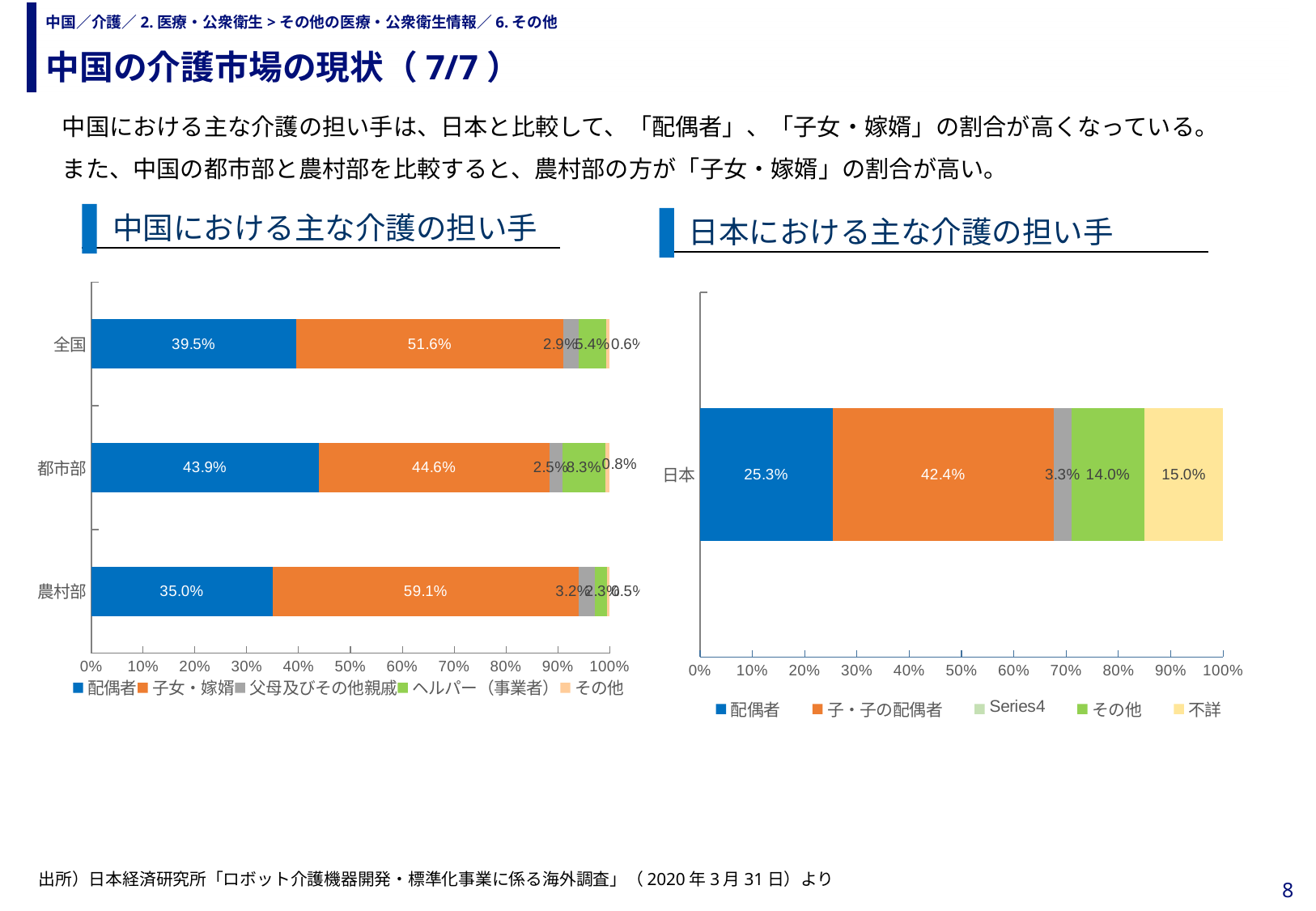
In the chart titled 中国における主な介護の担い手, how many categories are shown on the vertical axis? 3 In the chart titled 日本における主な介護の担い手, what is the value for 子・子の配偶者? 42.4% In the chart titled 日本における主な介護の担い手, what is the value for 不詳? 15.0% In the chart titled 中国における主な介護の担い手, what is the value for 配偶者 in 全国? 39.5% In the chart titled 日本における主な介護の担い手, which is larger, the value for 配偶者 or the value for 子・子の配偶者? 子・子の配偶者 In the chart titled 日本における主な介護の担い手, how many series does the legend list? 5 In the chart titled 中国における主な介護の担い手, which category has the highest value for 子女・嫁婿? 農村部 In the chart titled 中国における主な介護の担い手, which category has the lowest value for 配偶者? 農村部 In the chart titled 中国における主な介護の担い手, what is the value for ヘルパー（事業者） in 都市部? 8.3% What type of chart is the chart titled 日本における主な介護の担い手? Stacked bar chart In the chart titled 中国における主な介護の担い手, what is the difference between the 配偶者 values for 都市部 and 農村部? 8.9% In the chart titled 中国における主な介護の担い手, what is the value for 子女・嫁婿 in 農村部? 59.1%